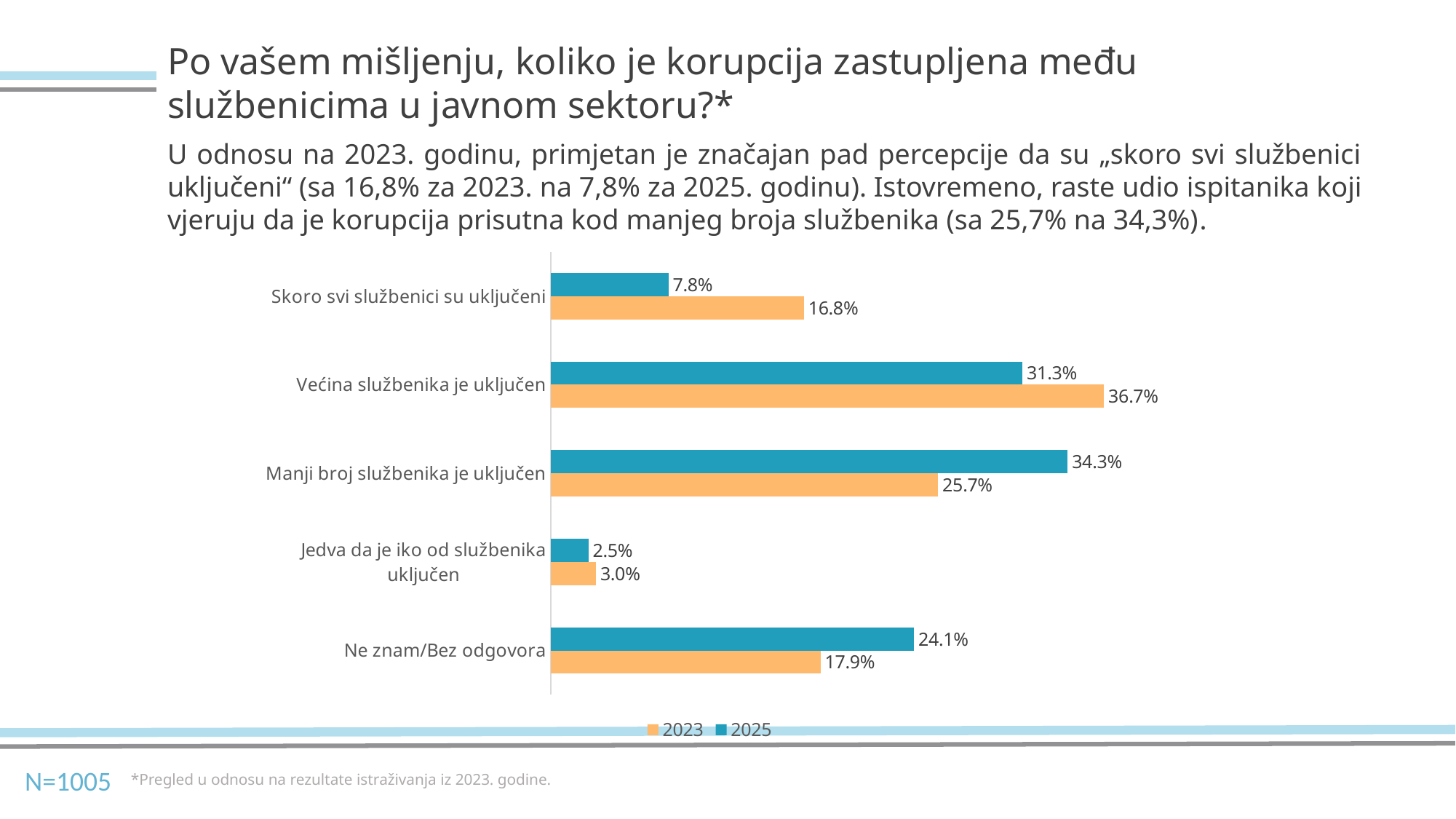
What is the difference between the 2025 and 2023 values for "Manji broj službenika je uključen"? 8.6% How many categories are shown on the chart? 5 Which category has the highest 2025 value? Manji broj službenika je uključen What is the 2025 value for "Skoro svi službenici su uključeni"? 7.8% What is the 2025 value for "Ne znam/Bez odgovora"? 24.1% For "Ne znam/Bez odgovora", which year has the larger value, 2023 or 2025? 2025 Which colour represents the 2023 series in the chart? Orange What kind of chart is shown on the slide? Bar chart What is the 2023 value for "Većina službenika je uključen"? 36.7% What is the difference between the 2023 and 2025 values for "Skoro svi službenici su uključeni"? 9.0% Which category has the lowest 2023 value? Jedva da je iko od službenika uključen How many series does the legend list? 2